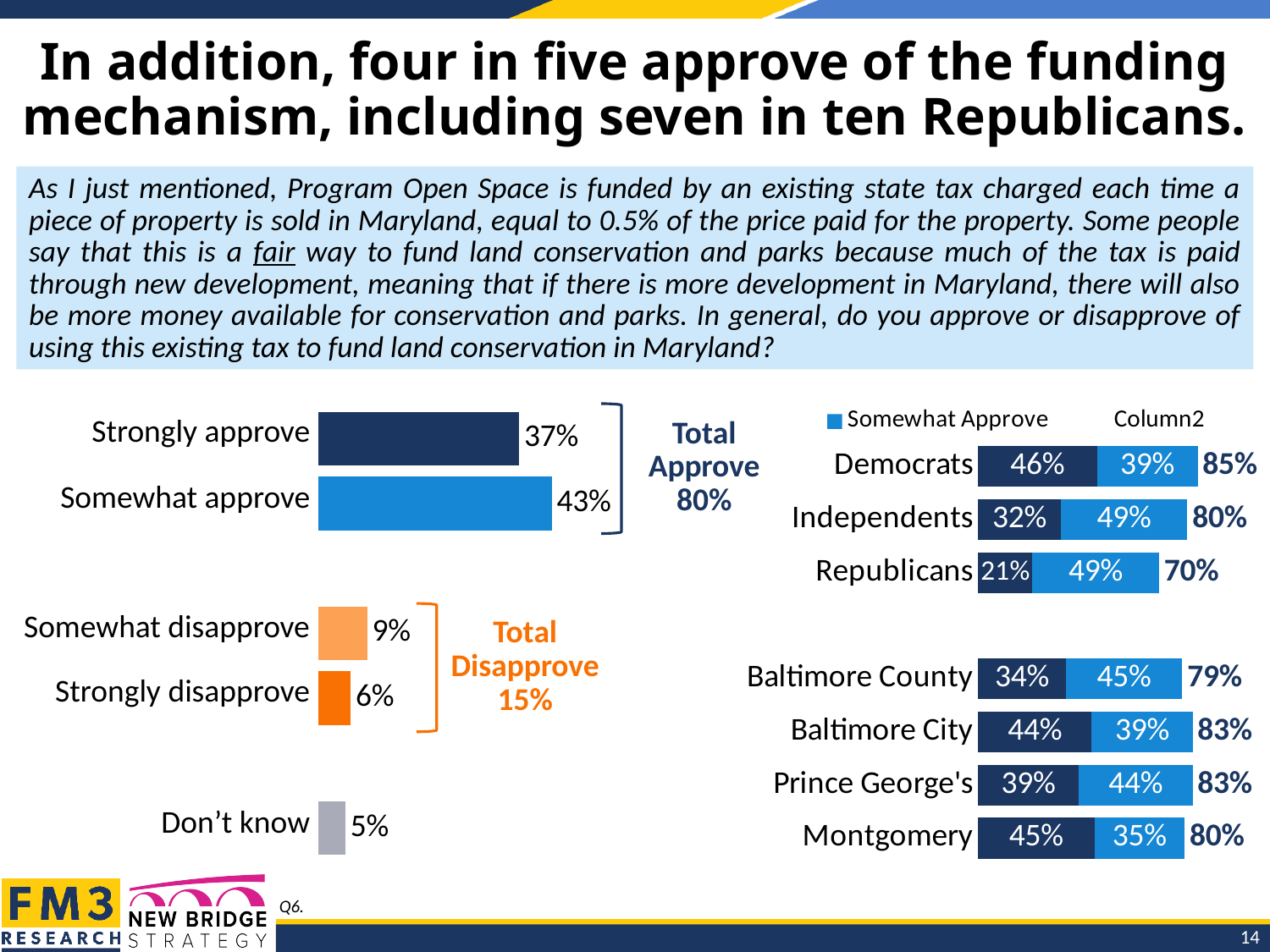
In the left bar chart, how many percentage points higher is "Somewhat approve" than "Strongly approve"? 6 percentage points In the right stacked bar chart, which has a higher total approval: Baltimore City or Baltimore County? Baltimore City In the right stacked bar chart, what value is shown in the dark blue segment for Democrats? 46% In the right stacked bar chart, which of the three party groups has the lowest total approval? Republicans In the left bar chart, which response category has the lowest value? Don't know What type of chart is the left chart showing approval responses? Bar chart In the right stacked bar chart, what is the total approval percentage shown for Republicans? 70% In the left bar chart, what percentage of respondents said they strongly approve? 37% What Total Approve percentage is labeled next to the left bar chart? 80% In the left bar chart, what percentage of respondents answered "Don't know"? 5% How many response categories are shown in the left bar chart? 5 In the left bar chart, which response category has the highest value? Somewhat approve